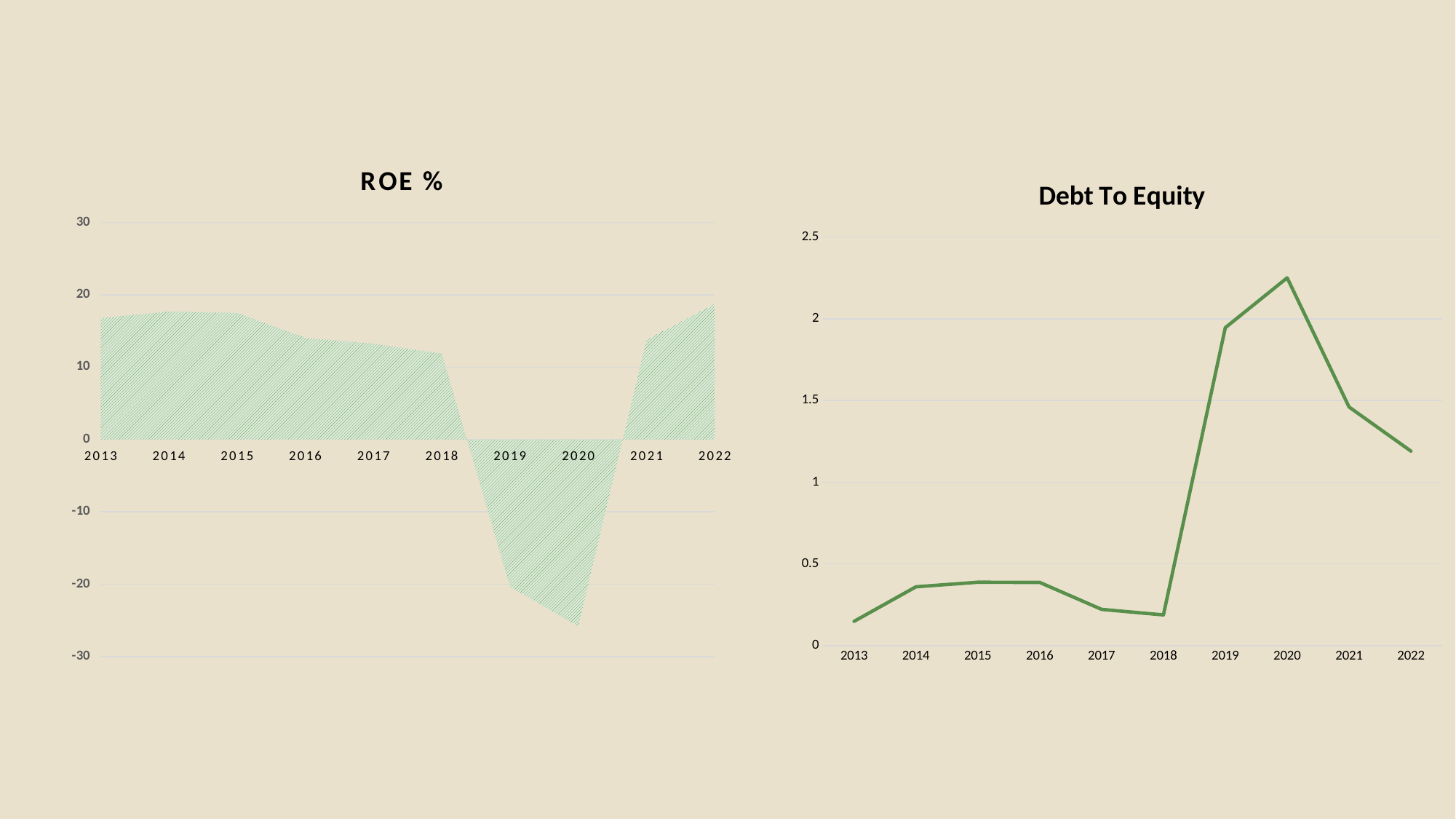
In the Debt To Equity chart, is the value for 2022 greater or less than 1? greater In the ROE % chart, is the value for 2020 greater or less than -20? less What kind of chart is the Debt To Equity chart? line chart In the ROE % chart, is the value for 2018 greater or less than 10? greater How many years are shown on the x axis of the Debt To Equity chart? 10 In the ROE % chart, which year has the lowest value? 2020 What kind of chart is the ROE % chart? area chart In the Debt To Equity chart, do the values rise or fall from 2020 to 2022? fall In the Debt To Equity chart, which year has the highest value? 2020 In the ROE % chart, is the value for 2019 larger or smaller than the value for 2021? smaller